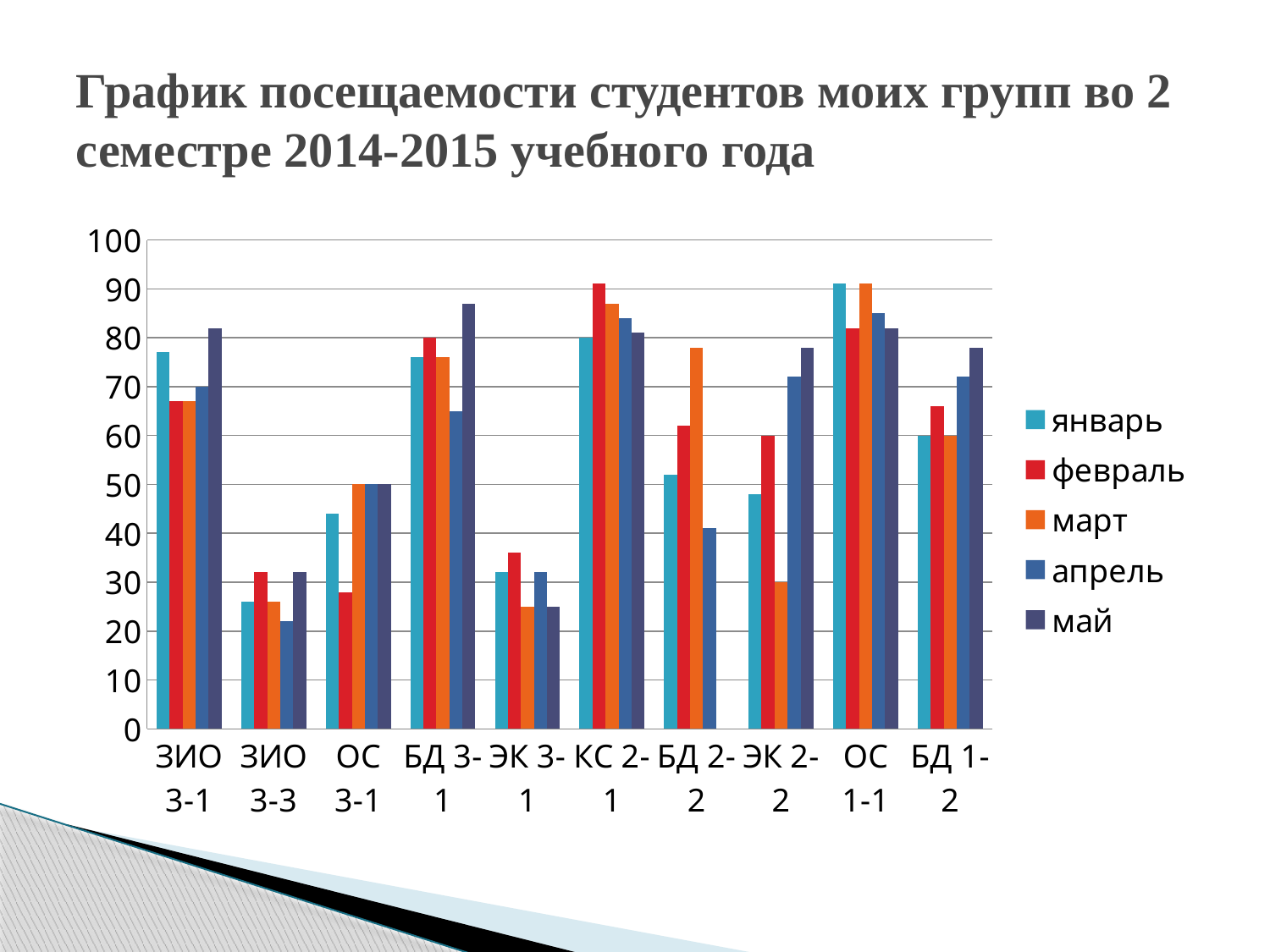
What is the value for январь for group БД 1-2? 60 Is the value for январь for group ОС 1-1 greater or less than 80? greater How many student groups (categories) are shown on the x axis? 10 What kind of chart is shown on the slide? bar chart Which group has the lowest май value? ЭК 3-1 What is the value for январь for group КС 2-1? 80 How many series does the legend list? 5 Which group has the highest январь value? ОС 1-1 What is the value for март for group ОС 3-1? 50 Is the value for январь for group ЗИО 3-3 greater or less than 30? less Which months are listed in the legend? январь, февраль, март, апрель, май